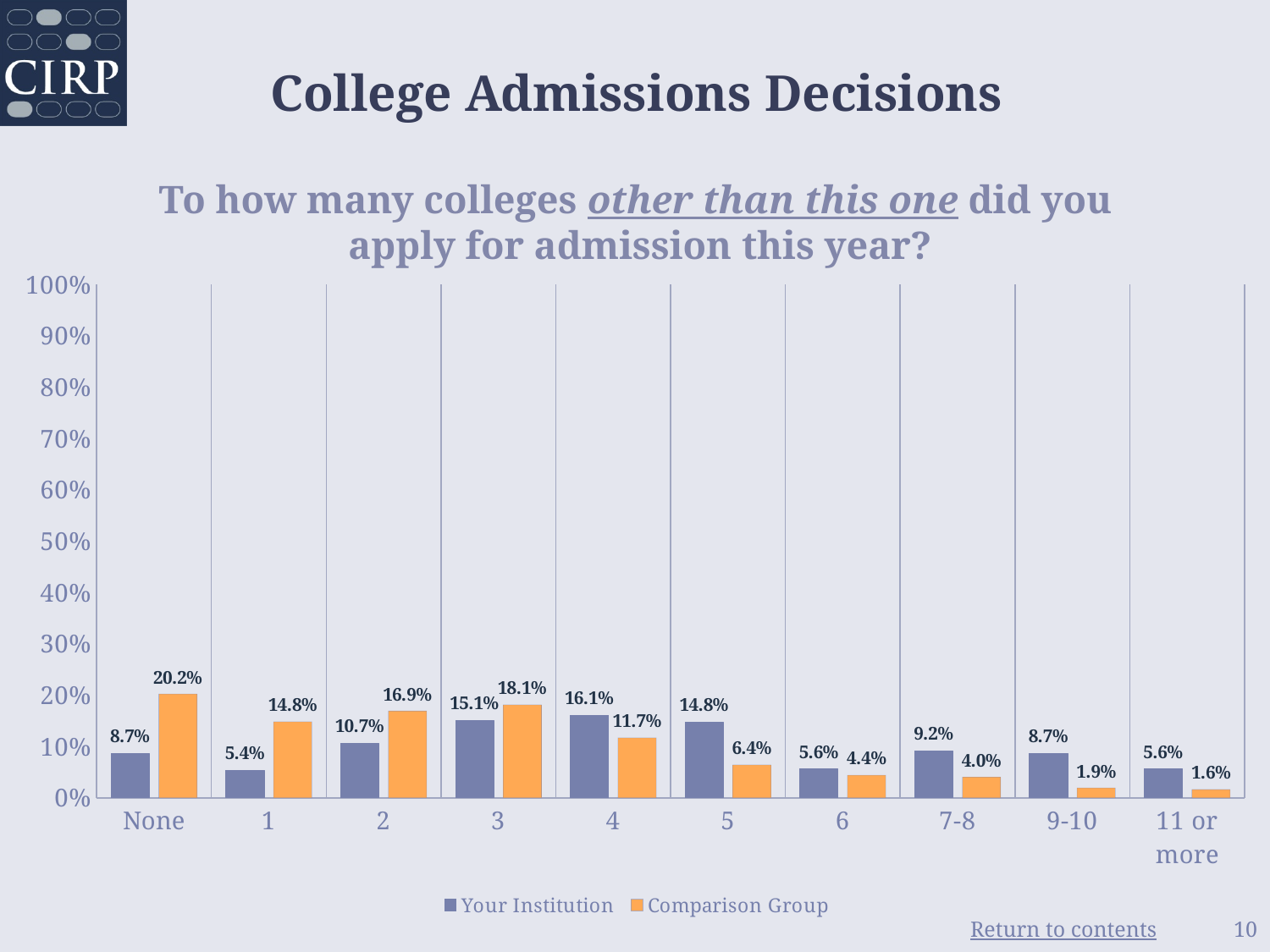
What is the value for Your Institution in the 9-10 category? 8.7% What is the difference between Comparison Group and Your Institution in the None category? 11.5% How many series does the legend list? 2 Which category has the lowest value for Comparison Group? 11 or more Which is larger in the 5 category, Your Institution or Comparison Group? Your Institution What kind of chart is shown on the slide? bar chart How many categories are shown on the x axis? 10 Is the value for Comparison Group in the 2 category greater or less than 20%? less Which category has the highest value for Comparison Group? None What is the value for Your Institution in the None category? 8.7% Which category has the highest value for Your Institution? 4 What is the value for Comparison Group in the 3 category? 18.1%